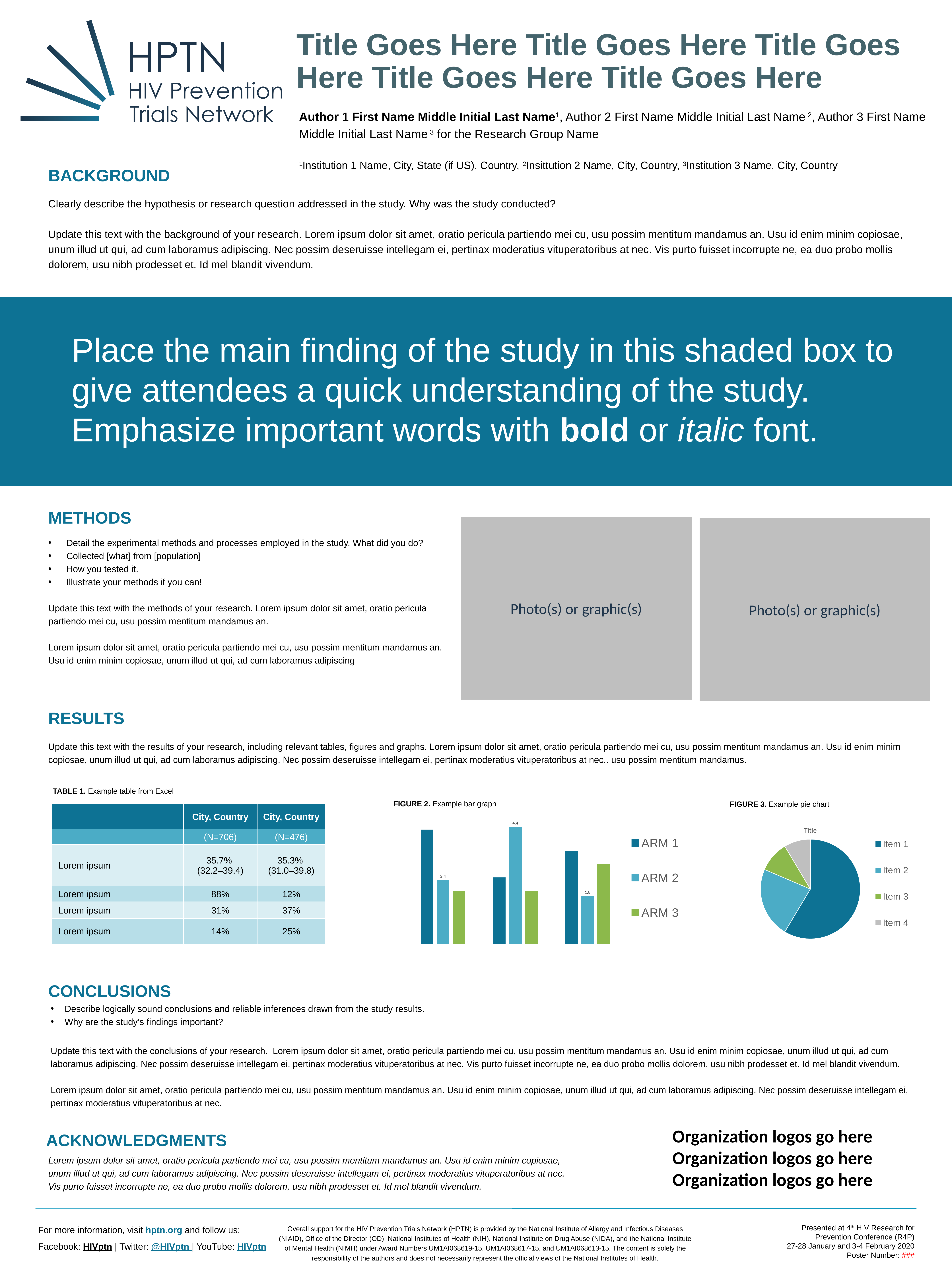
In Figure 2, which series has the tallest bar in the middle group? ARM 2 In Figure 2, what is the labeled value of the ARM 2 bar in the third group from the left? 1.8 In Figure 2, how many groups of bars are plotted? 3 In Figure 2, what is the difference between the ARM 2 values in the middle group (4.4) and the first group (2.4)? 2.0 What are the legend entries in Figure 2? ARM 1, ARM 2, ARM 3 How many series does the legend of Figure 2 list? 3 What kind of chart is Figure 3 (Example pie chart)? pie chart What kind of chart is Figure 2 (Example bar graph)? bar chart How many slices does the pie chart in Figure 3 have? 4 In Figure 3, which item has the largest slice of the pie? Item 1 In Figure 2, what is the labeled value of the ARM 2 bar in the first group from the left? 2.4 In Figure 2, what is the labeled value of the ARM 2 bar in the middle group? 4.4